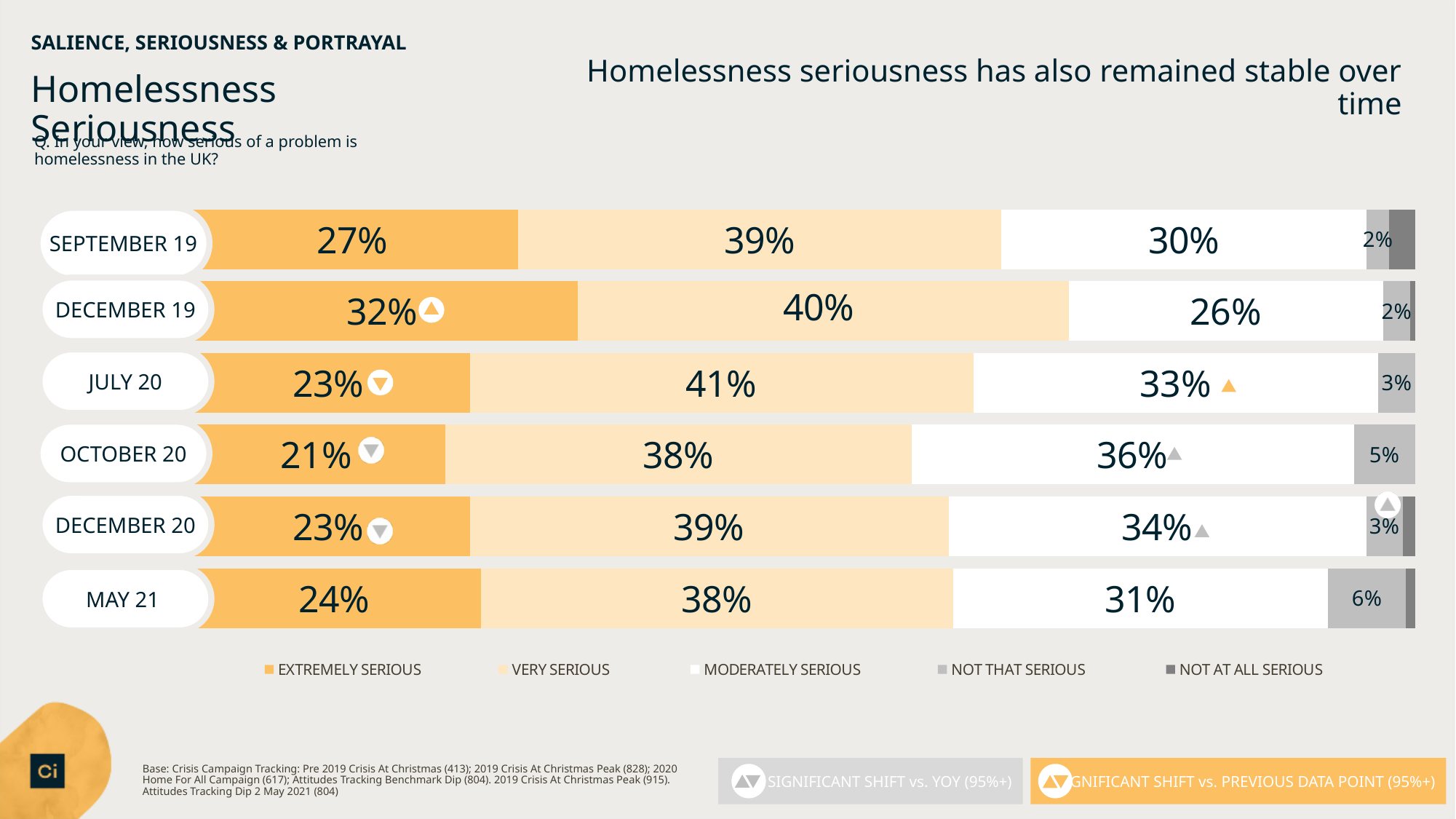
Which is larger: the 'Extremely serious' value for December 19 or for May 21? December 19 What is the 'Not that serious' value for May 21? 6% Which time period has the highest 'Moderately serious' value? October 20 How many time periods are shown in the chart? 6 What kind of chart is shown on the slide? Stacked bar chart What is the 'Very serious' value for July 20? 41% What is the 'Moderately serious' value for October 20? 36% How many series does the legend list? 5 What is the difference between the 'Very serious' values for July 20 and October 20? 3 percentage points Which time period has the highest 'Extremely serious' value? December 19 Which time period has the lowest 'Extremely serious' value? October 20 What percentage of respondents said homelessness was extremely serious in September 19? 27%